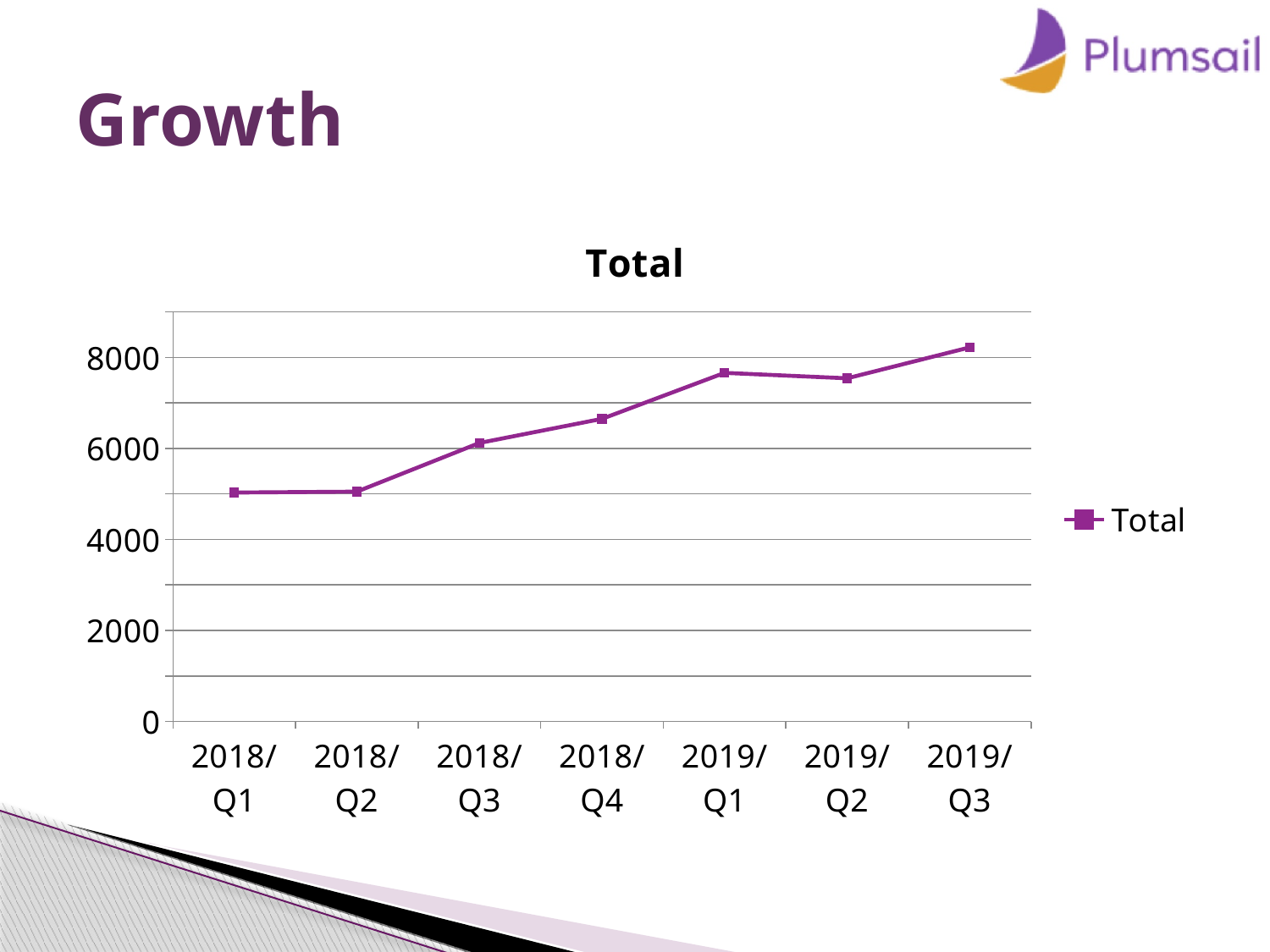
What is the title of the chart? Total What kind of chart is shown on the slide? line chart Which quarter has the highest Total value? 2019/Q3 How many data points are plotted on the line? 7 Which is larger, the value for 2018/Q4 or the value for 2019/Q1? 2019/Q1 Is the value for 2018/Q1 greater or less than 4000? greater Do the Total values generally rise or fall from 2018/Q1 to 2019/Q3? rise Is the value for 2019/Q1 greater or less than 8000? less Is the value for 2018/Q4 greater or less than 6000? greater How many series does the legend list? 1